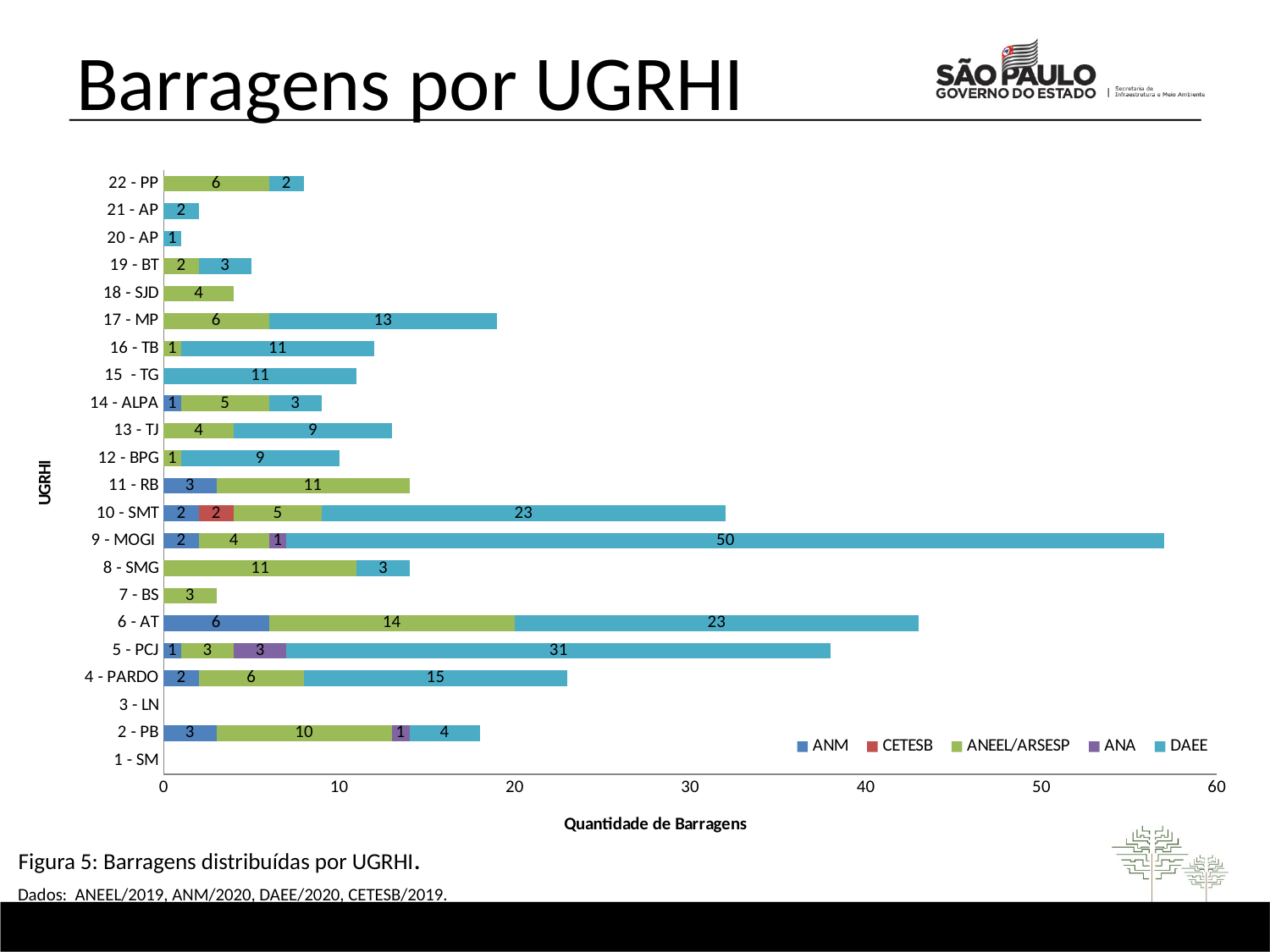
What is the label of the x axis? Quantidade de Barragens Is the total bar length for 9 - MOGI greater or less than 50? greater What is the DAEE value for 5 - PCJ? 31 What is the ANEEL/ARSESP value for 6 - AT? 14 What is the total number of barragens for 10 - SMT (sum of all segments)? 32 How many series does the legend list? 5 What is the total number of barragens for 4 - PARDO (sum of all segments)? 23 What kind of chart is shown on the slide? Stacked bar chart What is the DAEE value for 9 - MOGI? 50 Which UGRHI has the largest DAEE value? 9 - MOGI Which is larger: the ANEEL/ARSESP value for 8 - SMG or the ANEEL/ARSESP value for 22 - PP? 8 - SMG What is the difference between the DAEE value for 6 - AT and the DAEE value for 17 - MP? 10